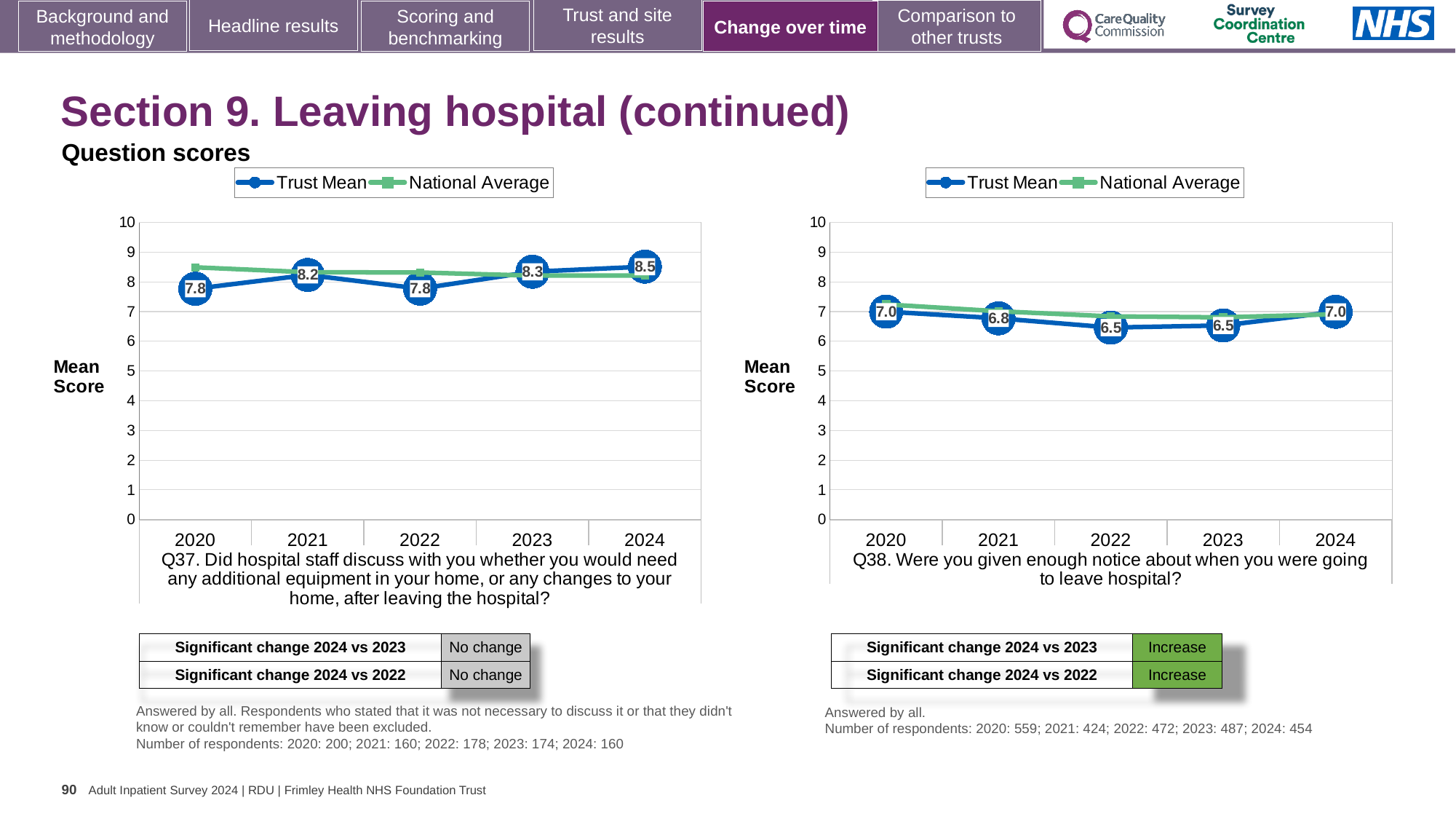
In the Q37 chart (left), is the Trust Mean score for 2021 greater or less than 8? greater In the Q38 chart (right), what is the difference between the Trust Mean scores for 2024 and 2022? 0.5 In the Q38 chart (right), how many years are shown on the x axis? 5 What kind of chart is the Q38 chart (right)? Line chart How many series does the legend of the Q37 chart (left) list? 2 In the Q37 chart (left), what is the Trust Mean score for 2020? 7.8 In the Q38 chart (right), what is the Trust Mean score for 2022? 6.5 In the Q37 chart (left), what is the Trust Mean score for 2024? 8.5 In the Q38 chart (right), what is the Trust Mean score for 2021? 6.8 In the Q37 chart (left), what is the difference between the Trust Mean scores for 2024 and 2023? 0.2 In the Q38 chart (right), which year has the lowest Trust Mean score, 2021 or 2022? 2022 In the Q37 chart (left), which year has the highest Trust Mean score? 2024